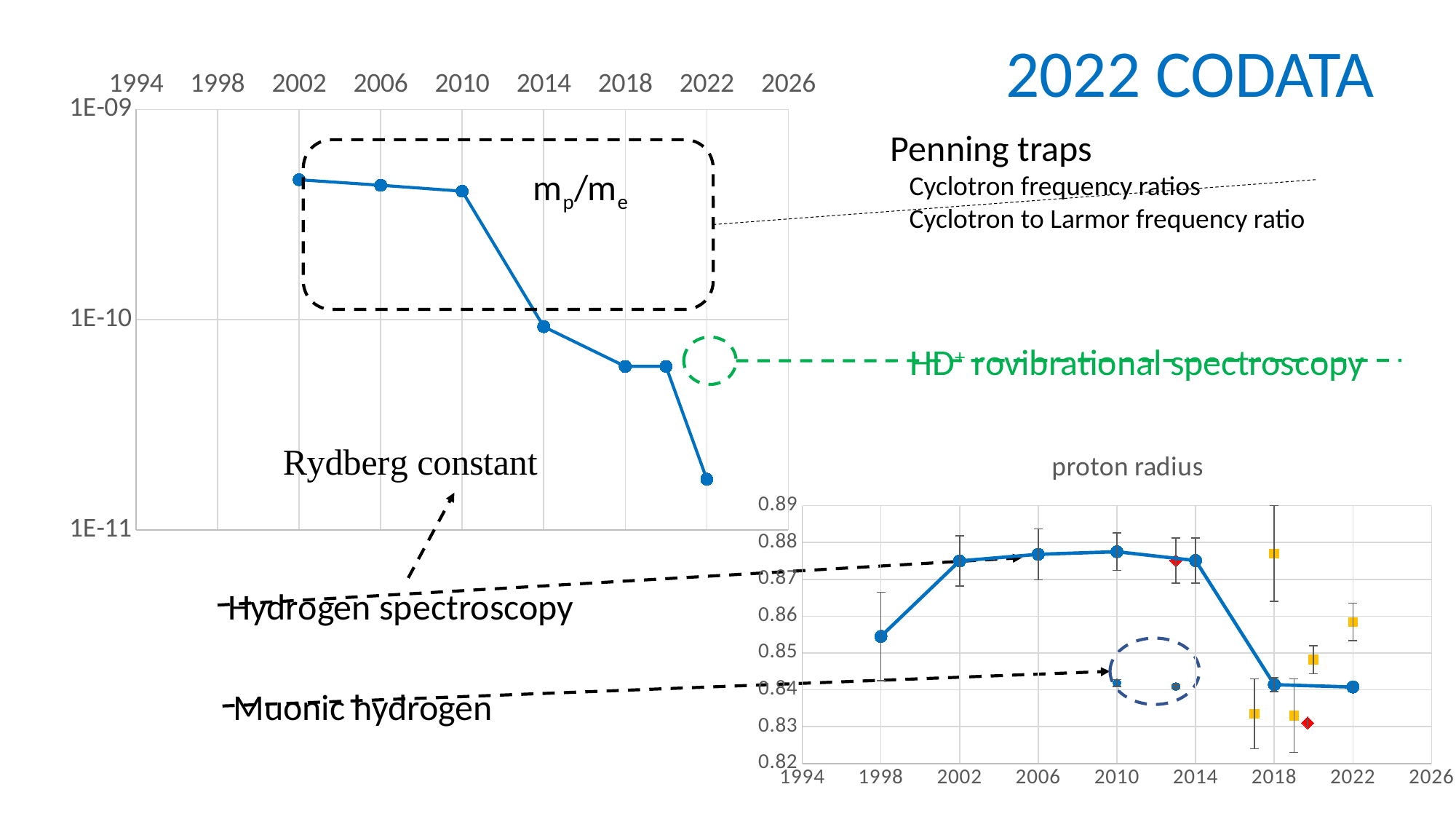
In the top-left chart, how many data points are plotted on the blue line? 7 In the proton radius chart, is the blue line value for 1998 greater or less than 0.85? greater What kind of chart is the top-left chart on the slide? line chart In the top-left chart, do the plotted values rise or fall from 2002 to 2022? fall In the top-left chart, is the value for 2022 greater or less than 1E-10? less In the proton radius chart, is the blue line value for 2022 greater or less than 0.85? less What is the title of the bottom-right chart? proton radius In the proton radius chart, which is larger, the blue line value for 2010 or the blue line value for 2018? 2010 In the top-left chart, which year has the lowest plotted value? 2022 In the top-left chart, which is larger, the value for 2010 or the value for 2014? 2010